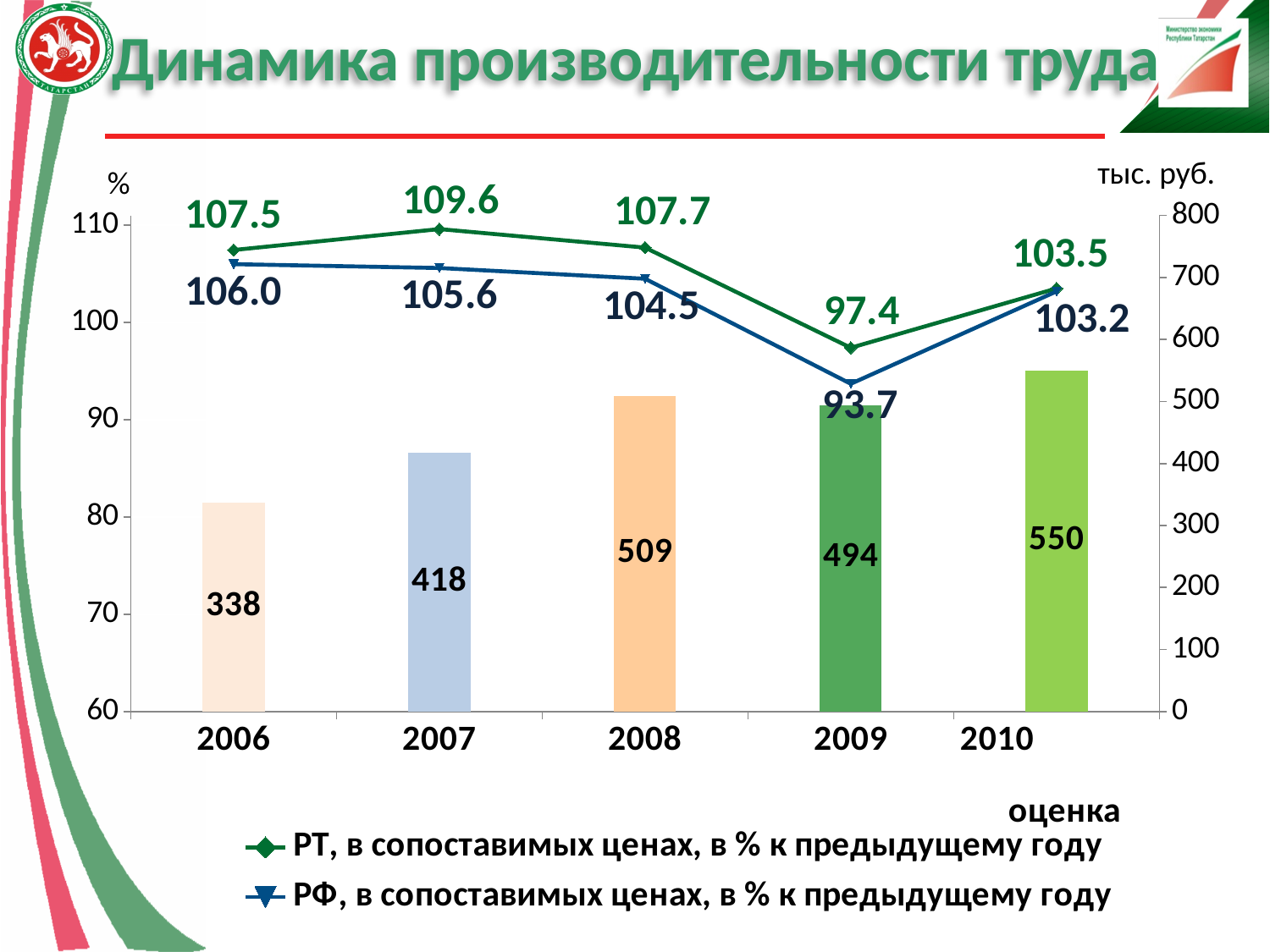
What is the value of the РФ line (РФ, в сопоставимых ценах, в % к предыдущему году) for 2007? 105.6 Which year has the highest bar value? 2010 What is the value of the РТ line (РТ, в сопоставимых ценах, в % к предыдущему году) for 2009? 97.4 What is the difference between the bar values for 2010 and 2009? 56 Which is larger in 2006: the РТ line value or the РФ line value? РТ line value (107.5) What is the value of the bar for 2008? 509 Which year has the highest value on the РТ line? 2007 What is the difference between the РТ and РФ line values in 2009? 3.7 What is the title of the slide's chart? Динамика производительности труда Which year has the lowest value on the РФ line? 2009 How many series does the legend list? 2 How many years are shown on the x axis? 5